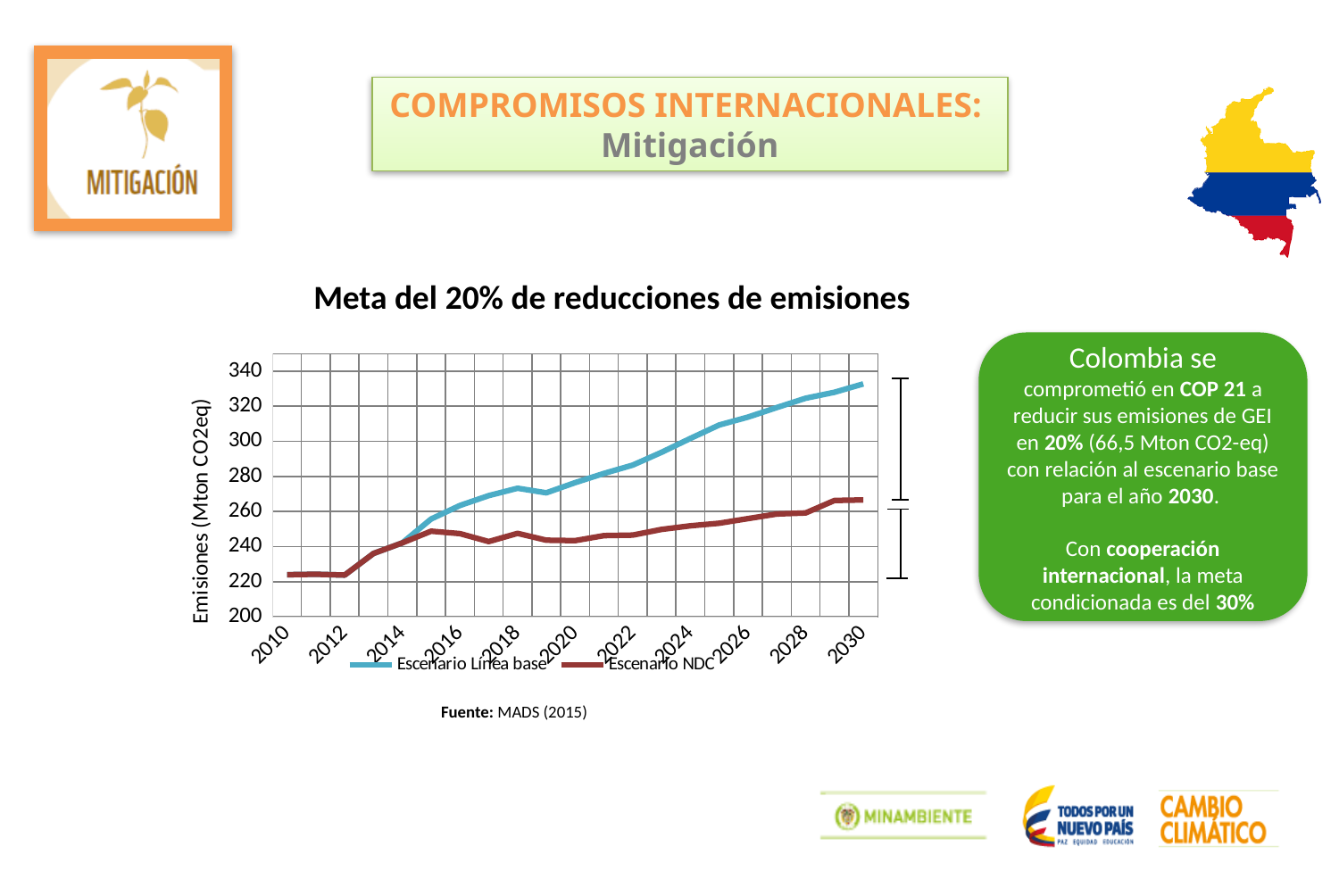
Is the value for Escenario Línea base in 2020 greater or less than 260? greater What are the two series named in the chart legend? Escenario Línea base and Escenario NDC In 2030, which series has the higher value, Escenario Línea base or Escenario NDC? Escenario Línea base Is the value for Escenario Línea base in 2010 greater or less than 240? less How many series does the chart legend list? 2 Does the Escenario Línea base series rise or fall from 2010 to 2030? rise Is the value for Escenario NDC in 2030 greater or less than 280? less What kind of chart is shown on the slide? line chart Which series is higher in 2026, Escenario NDC or Escenario Línea base? Escenario Línea base What is the label of the vertical axis of the chart? Emisiones (Mton CO2eq)